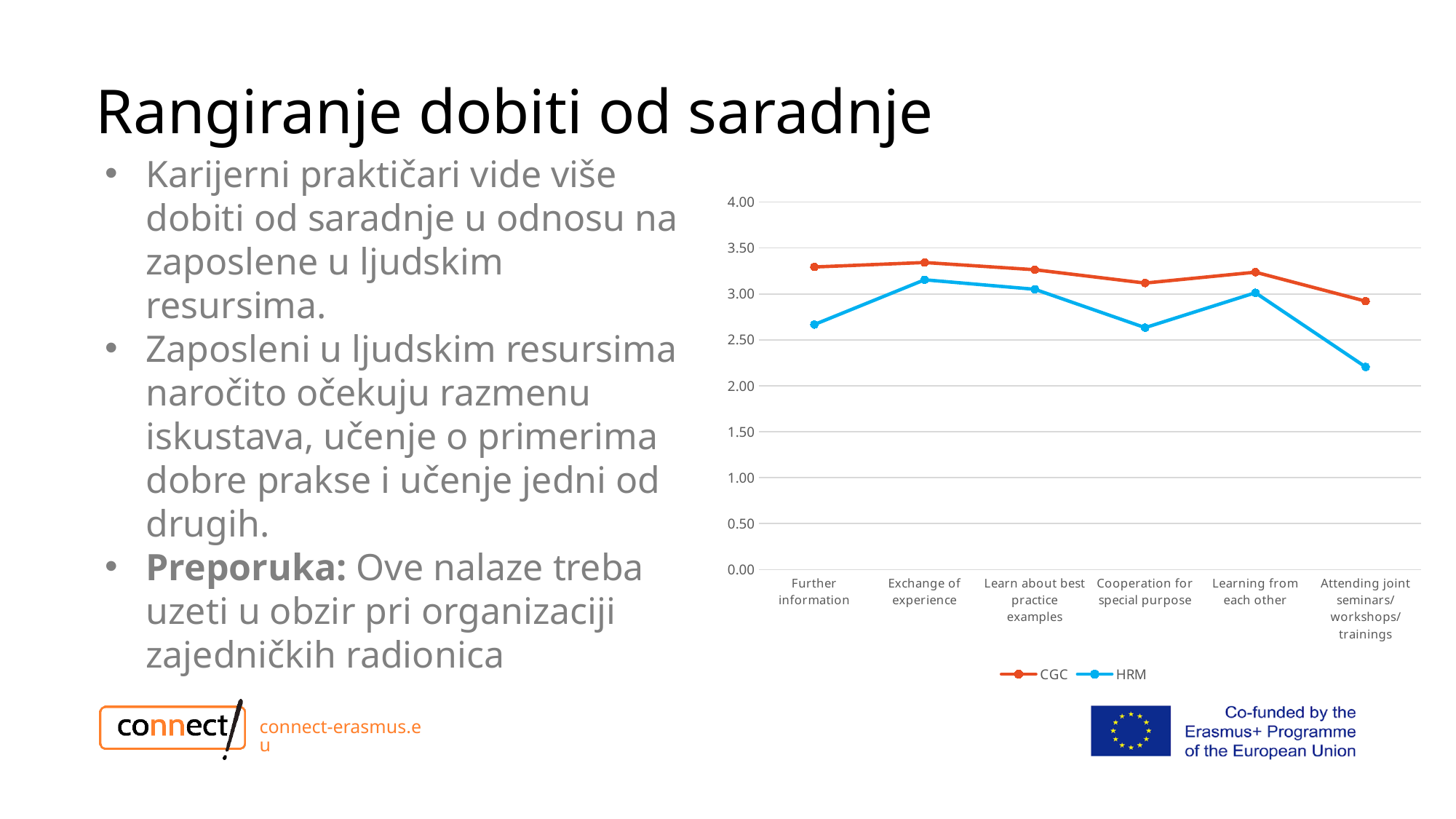
How many categories are shown on the x axis of the chart? 6 Does the HRM line rise or fall from Learning from each other to Attending joint seminars/workshops/trainings? fall For Further information, which series has the higher value, CGC or HRM? CGC Is the HRM value for Attending joint seminars/workshops/trainings greater or less than 2.50? less For which category is the CGC value lowest? Attending joint seminars/workshops/trainings What kind of chart is shown on the slide? line chart For which category is the HRM value lowest? Attending joint seminars/workshops/trainings Which series is plotted in blue in the chart? HRM Is the CGC value for Attending joint seminars/workshops/trainings greater or less than 3.00? less How many series does the chart legend list? 2 Is the CGC value for Further information greater or less than 3.00? greater